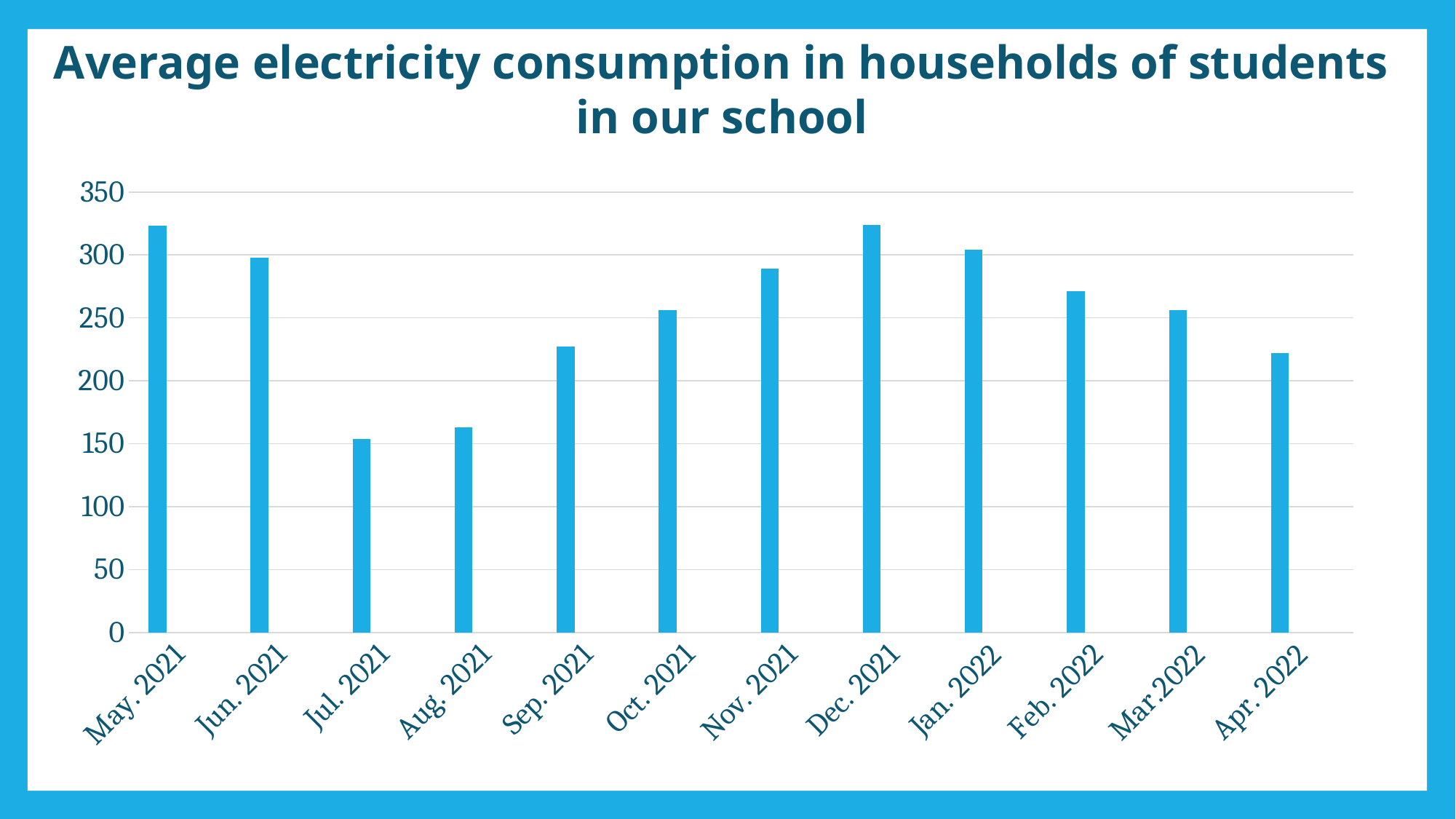
What kind of chart is shown on the slide? Bar chart Which is larger, the value for Feb. 2022 or the value for Apr. 2022? Feb. 2022 Which month has the lowest average electricity consumption? Jul. 2021 Do the values rise or fall from Jul. 2021 to Dec. 2021? rise Is the value for Apr. 2022 greater or less than 250? less What is the title of the chart? Average electricity consumption in households of students in our school Is the value for Jul. 2021 greater or less than 200? less How many months are plotted on the chart? 12 Is the value for Sep. 2021 greater or less than 250? less Which is larger, the value for Jun. 2021 or the value for Jul. 2021? Jun. 2021